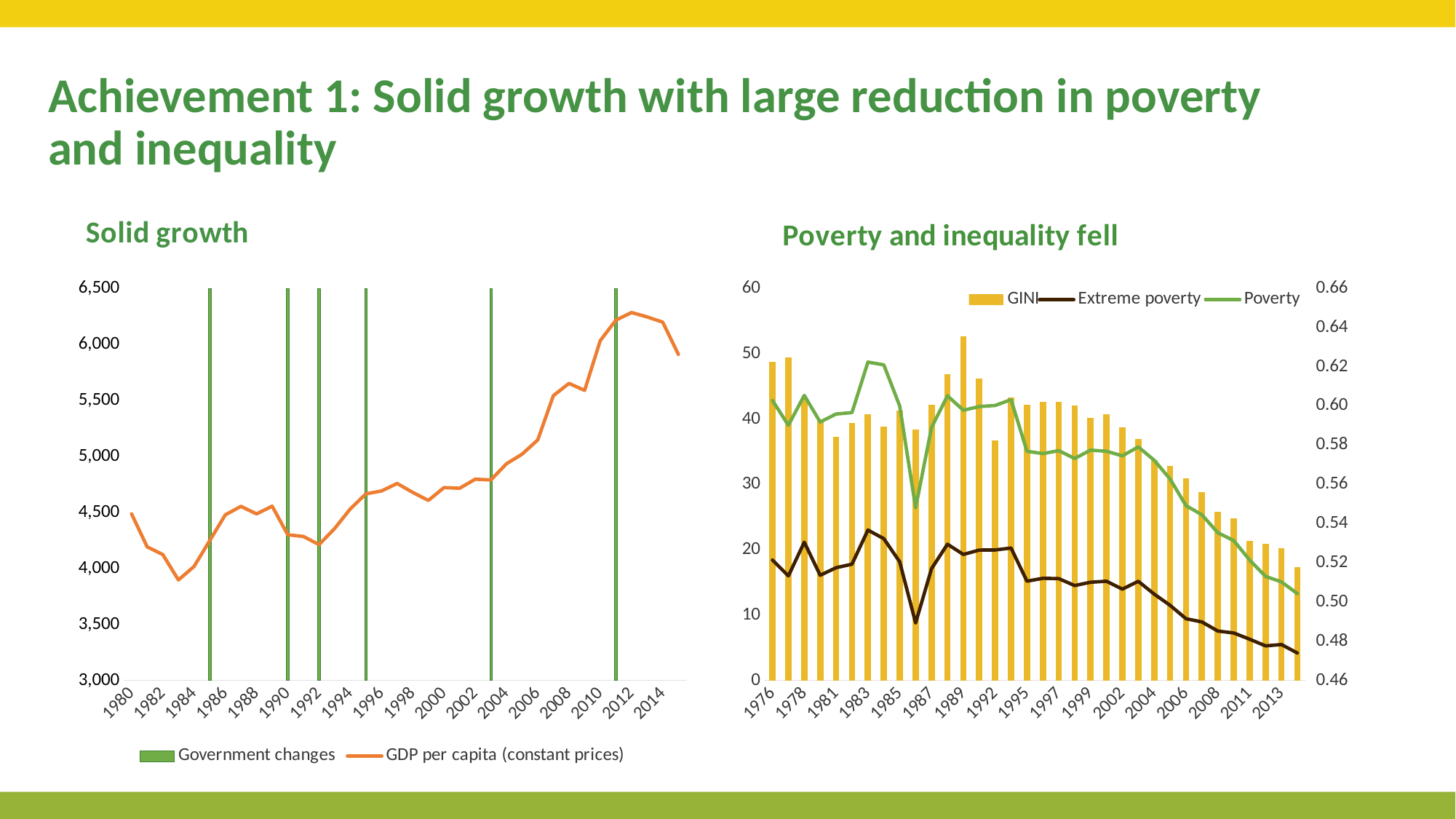
On the 'Solid growth' chart, how many series does the legend list? 2 On the 'Solid growth' chart, what kind of chart is used for GDP per capita (constant prices)? line chart On the 'Solid growth' chart, how many 'Government changes' bars are shown? 6 On the 'Solid growth' chart, does GDP per capita overall rise or fall between 1980 and 2014? rise On the 'Poverty and inequality fell' chart, which series is drawn as bars? GINI On the 'Poverty and inequality fell' chart, how many series does the legend list? 3 On the 'Poverty and inequality fell' chart, is the Poverty value for 1976 greater or less than 40? greater On the 'Poverty and inequality fell' chart, is the Extreme poverty value for 1987 greater or less than 10? greater On the 'Poverty and inequality fell' chart, in which year is the GINI bar highest? 1989 On the 'Solid growth' chart, is the GDP per capita value for 2012 greater or less than 6,000? greater On the 'Poverty and inequality fell' chart, does the Poverty line rise or fall from 1995 to 2013? fall